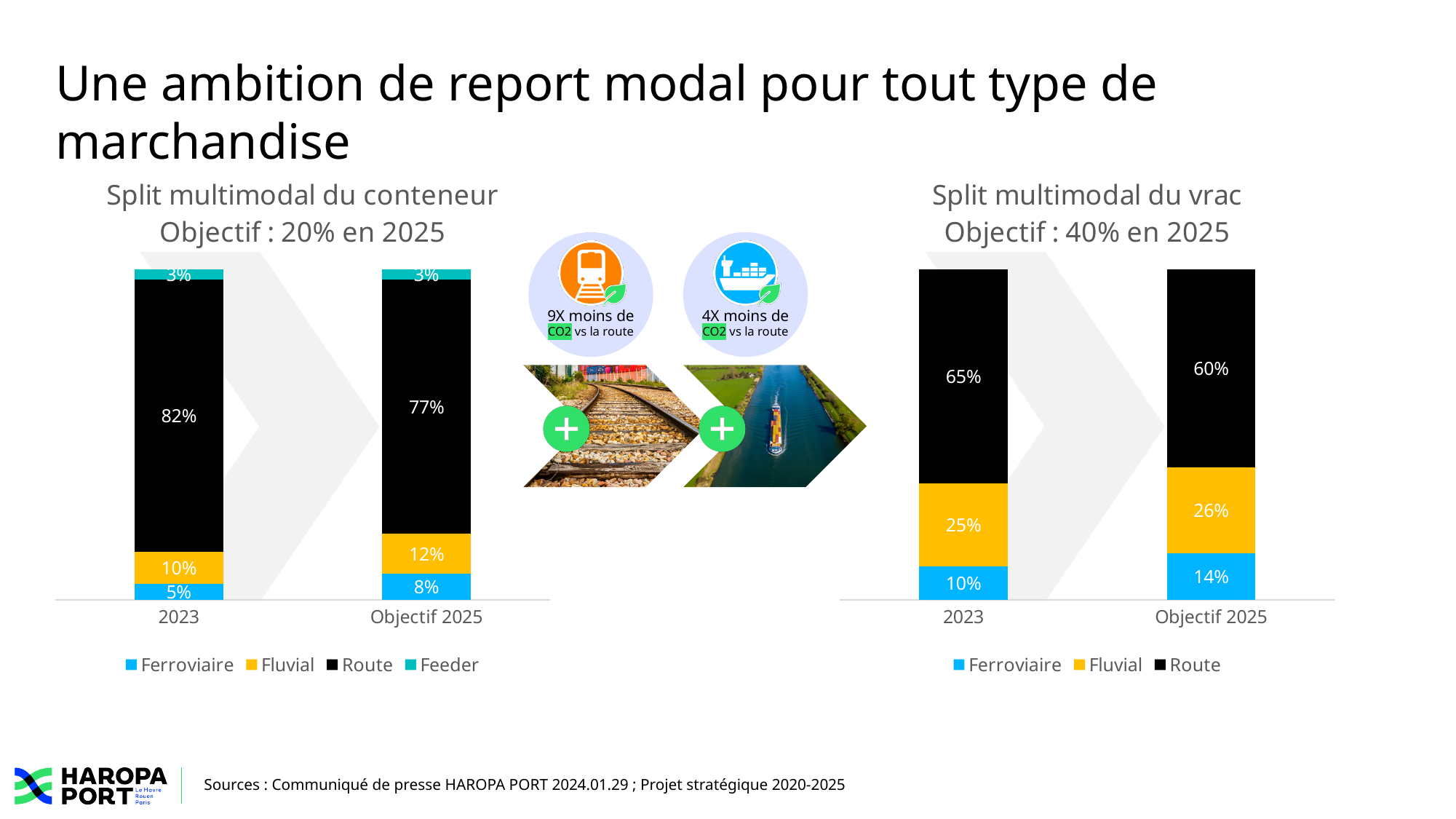
In the 'Split multimodal du vrac' chart, which series has the smallest share in Objectif 2025? Ferroviaire In the 'Split multimodal du conteneur' chart, what is the value for Ferroviaire in Objectif 2025? 8% In the 'Split multimodal du vrac' chart, what is the value for Fluvial in 2023? 25% In the 'Split multimodal du conteneur' chart, does the Route share rise or fall from 2023 to Objectif 2025? Fall In the 'Split multimodal du conteneur' chart, is the Fluvial value larger in 2023 or in Objectif 2025? Objectif 2025 What kind of chart is the 'Split multimodal du vrac' chart? Stacked bar chart In the 'Split multimodal du vrac' chart, what is the value for Route in Objectif 2025? 60% In the 'Split multimodal du conteneur' chart, which series has the largest share in 2023? Route In the 'Split multimodal du vrac' chart, what is the difference between the Route value in 2023 and in Objectif 2025? 5% How many series does the legend of the 'Split multimodal du conteneur' chart list? 4 How many series does the legend of the 'Split multimodal du vrac' chart list? 3 In the 'Split multimodal du conteneur' chart, what is the value for Route in 2023? 82%